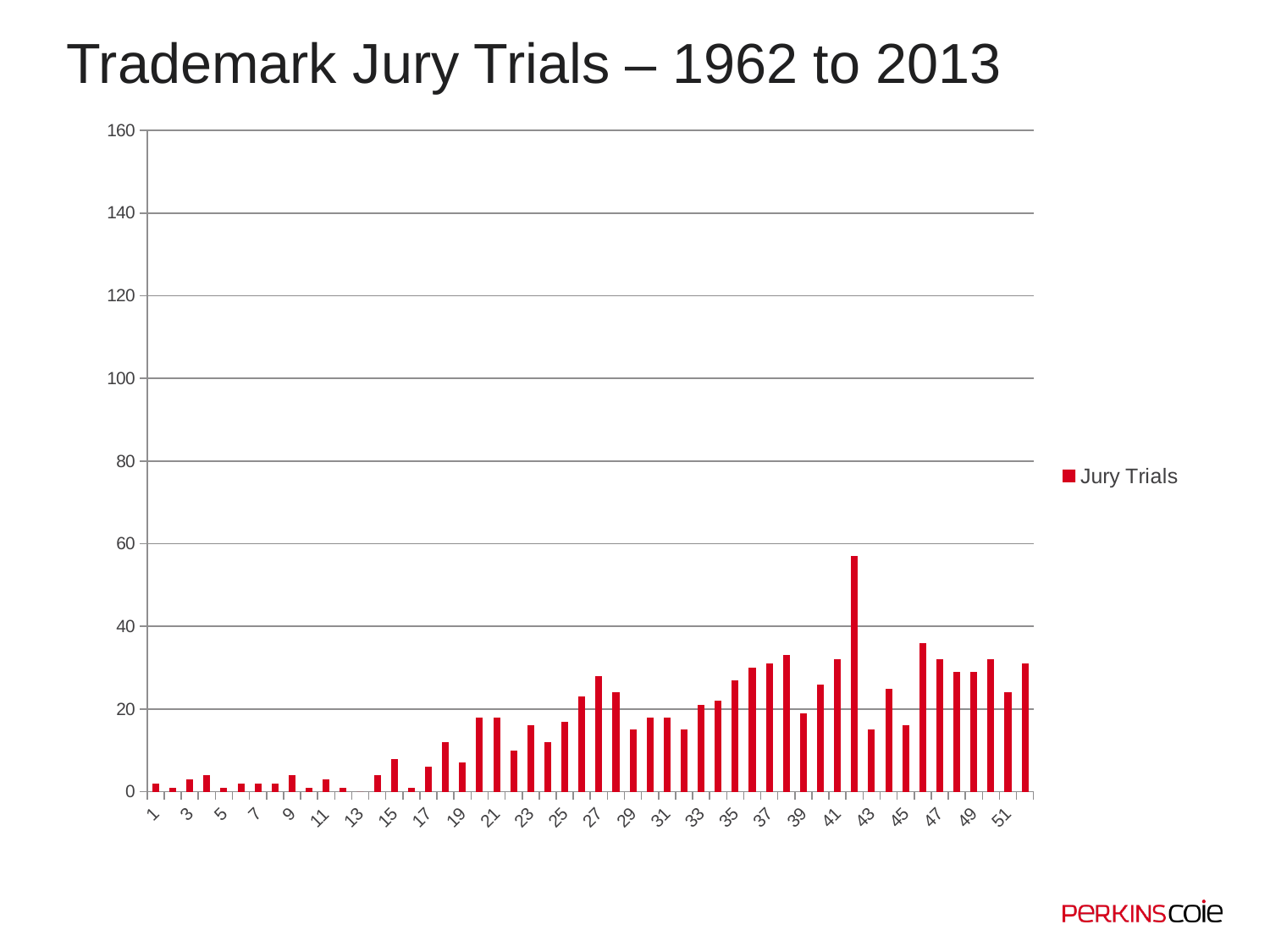
Is the value for category 35 greater or less than 20? greater Is the value for category 41 greater or less than 20? greater What is the name of the series shown in the legend? Jury Trials What is the title of the chart? Trademark Jury Trials – 1962 to 2013 What kind of chart is shown on the slide? bar chart Is the value for category 19 greater or less than 20? less How many series does the legend list? 1 Which has the larger value, category 41 or category 43? 41 Do the values generally rise or fall from left to right along the x axis? rise Which has the larger value, category 1 or category 51? 51